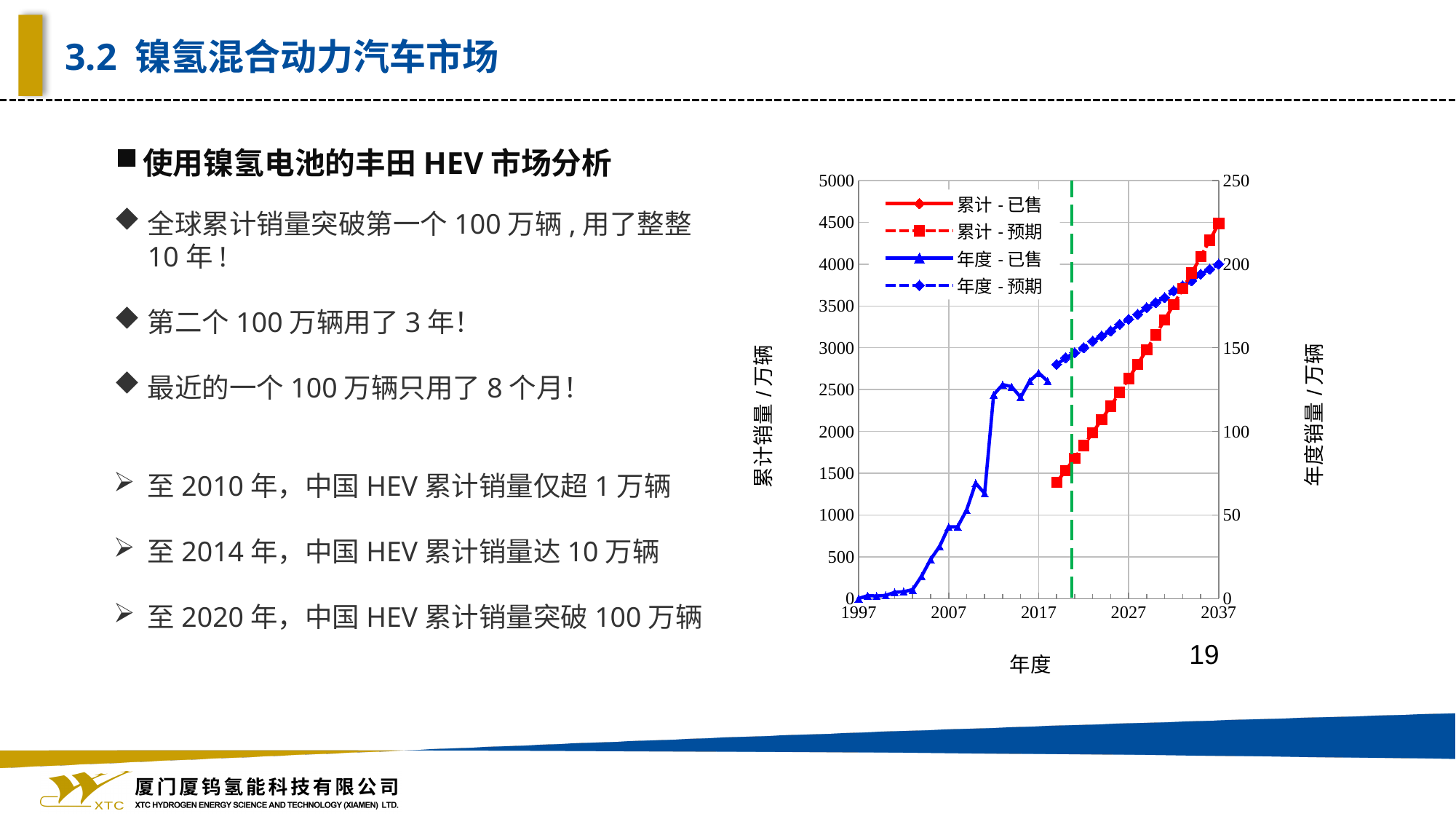
What is the last year shown on the x axis of the chart? 2037 What kind of chart is shown on the slide? line chart Does the 年度 - 已售 series generally rise or fall from 1997 to 2017? rise Is the 累计 - 预期 value at 2037 greater or less than 4000 on the left axis? greater How many series does the chart legend list? 4 Is the 年度 - 已售 value at 2017 greater or less than 100 on the right axis? greater What is the first year shown on the x axis of the chart? 1997 What is the maximum value shown on the left vertical axis of the chart? 5000 Does the 累计 - 预期 series rise or fall from 2019 to 2037? rise What is the title of the right vertical axis of the chart? 年度销量 / 万辆 What is the maximum value shown on the right vertical axis of the chart? 250 What is the title of the left vertical axis of the chart? 累计销量 / 万辆